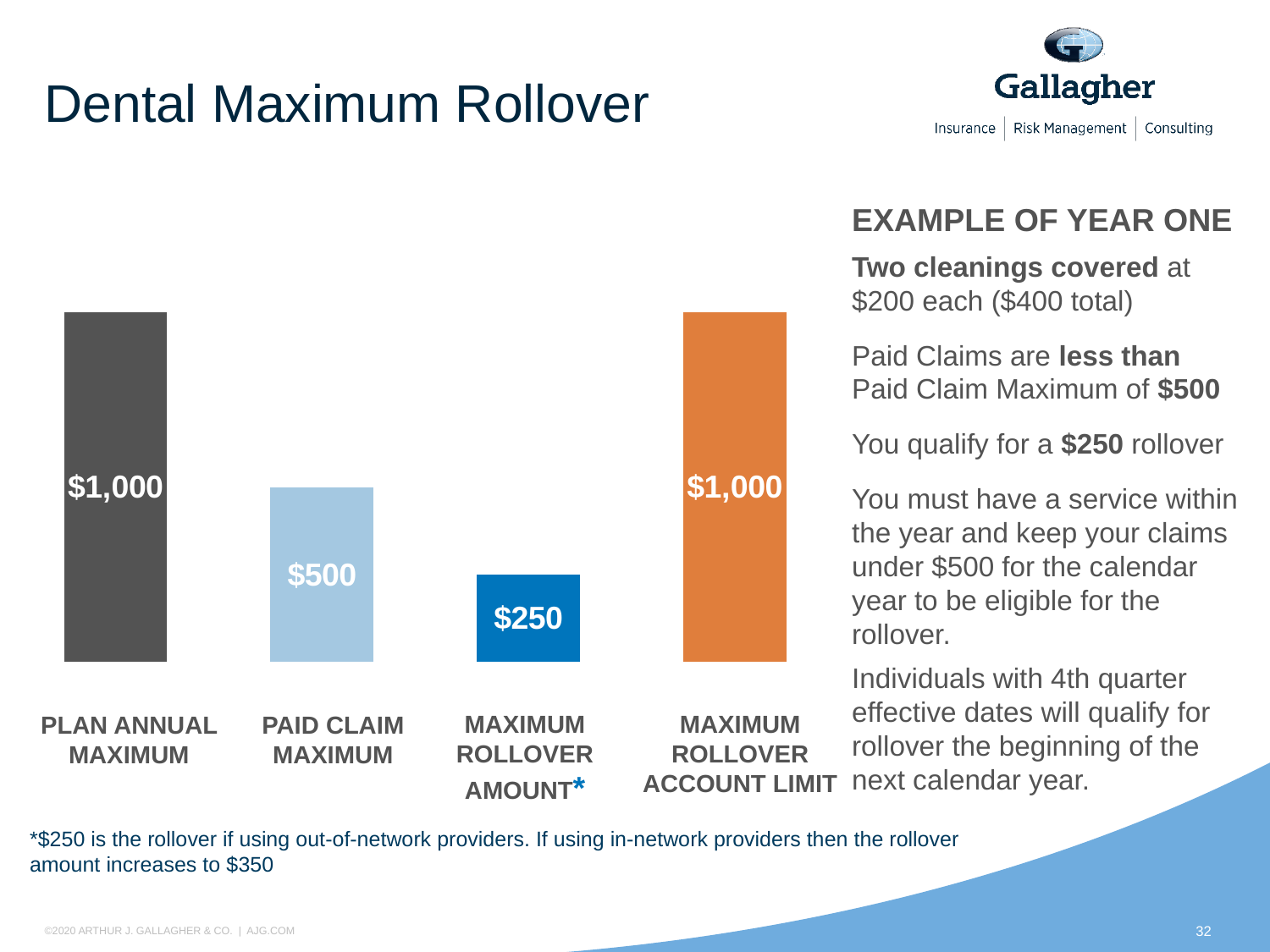
How many categories are shown in the chart? 4 What is the difference between Plan Annual Maximum and Paid Claim Maximum? $500 What colour is the bar for Maximum Rollover Account Limit? Orange Which is larger, Paid Claim Maximum or Maximum Rollover Amount? Paid Claim Maximum What is the value for Plan Annual Maximum? $1,000 What is the value for Maximum Rollover Amount? $250 Which category has the lowest value? Maximum Rollover Amount What is the difference between Paid Claim Maximum and Maximum Rollover Amount? $250 What is the value for Maximum Rollover Account Limit? $1,000 What is the value for Paid Claim Maximum? $500 Which category label carries an asterisk footnote marker? Maximum Rollover Amount What kind of chart is shown on the slide? Bar chart